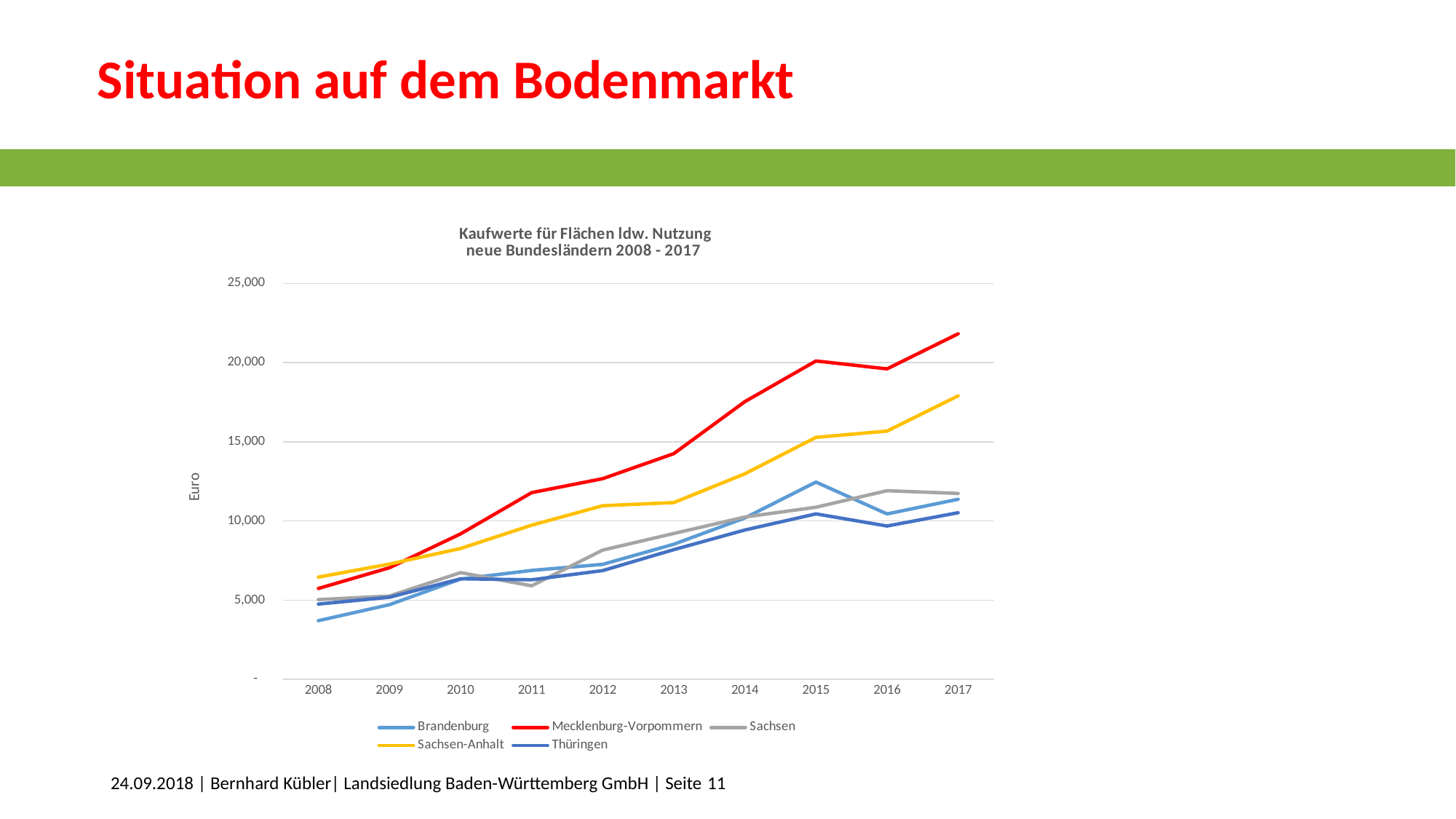
Do the values for Mecklenburg-Vorpommern rise or fall from 2008 to 2017? rise What kind of chart is shown on the slide? line chart In 2017, which is larger: the value for Sachsen-Anhalt or the value for Thüringen? Sachsen-Anhalt What is the label on the y axis? Euro Is the value for Mecklenburg-Vorpommern in 2017 greater or less than 20,000? greater Is the value for Sachsen-Anhalt in 2017 greater or less than 20,000? less Which series is drawn in red? Mecklenburg-Vorpommern How many years are shown on the x axis? 10 Is the value for Brandenburg in 2015 greater or less than 10,000? greater How many series does the legend list? 5 Which Bundesland has the highest value in 2017? Mecklenburg-Vorpommern Which Bundesland has the lowest value in 2008? Brandenburg